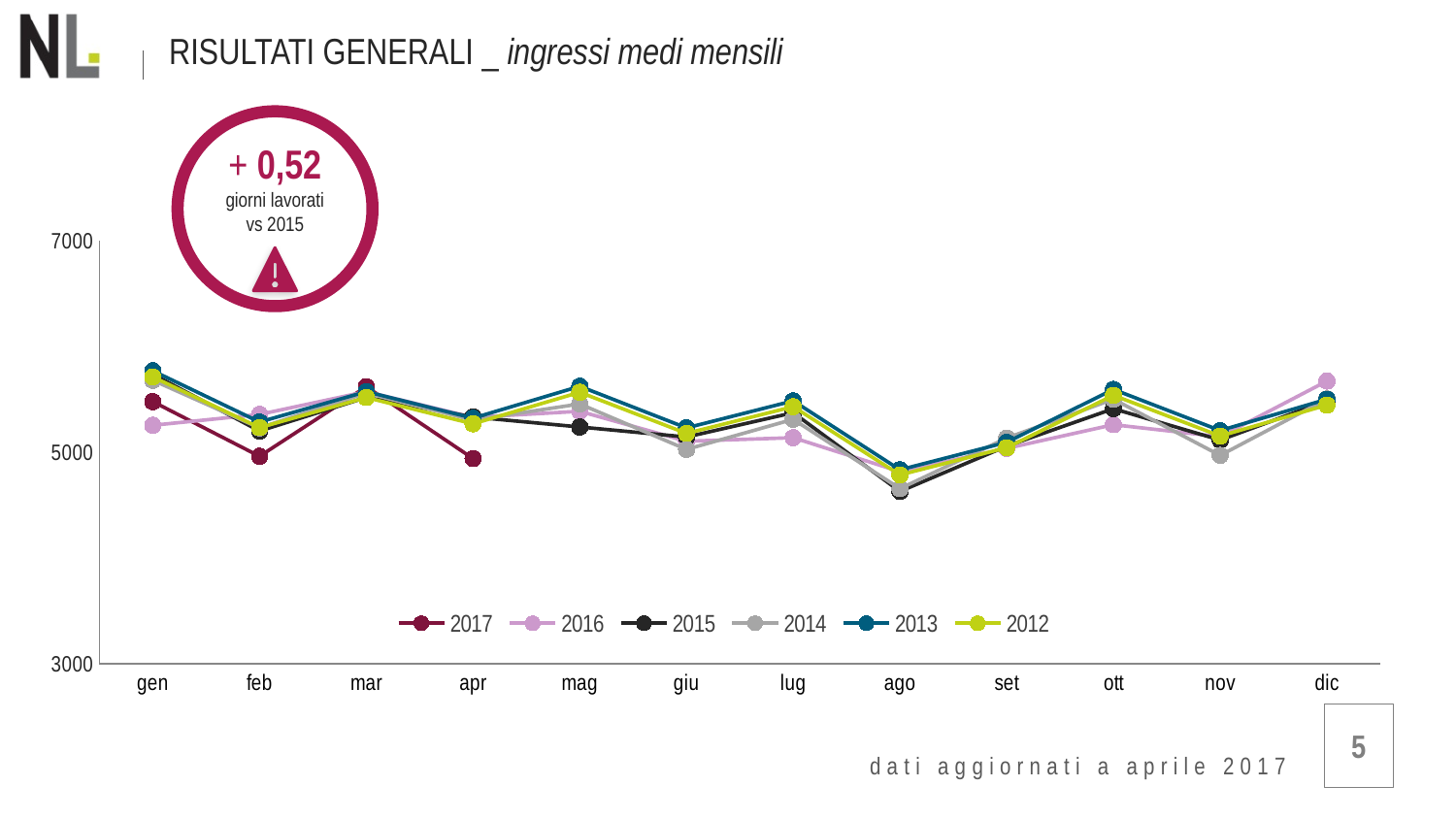
How many months are shown along the x axis? 12 Is the value for 2017 in mar greater or less than 5000? greater Which series is listed first in the legend? 2017 Does the 2016 line rise or fall from nov to dic? rise Is the value for 2013 in gen greater or less than 5000? greater What kind of chart is shown on the slide? line chart Is the value for 2014 in ago greater or less than 5000? less Which is larger for 2017: the value in gen or the value in feb? gen In which month is the 2014 series at its lowest? ago How many series does the legend list? 6 Does the 2017 line rise or fall from gen to feb? fall